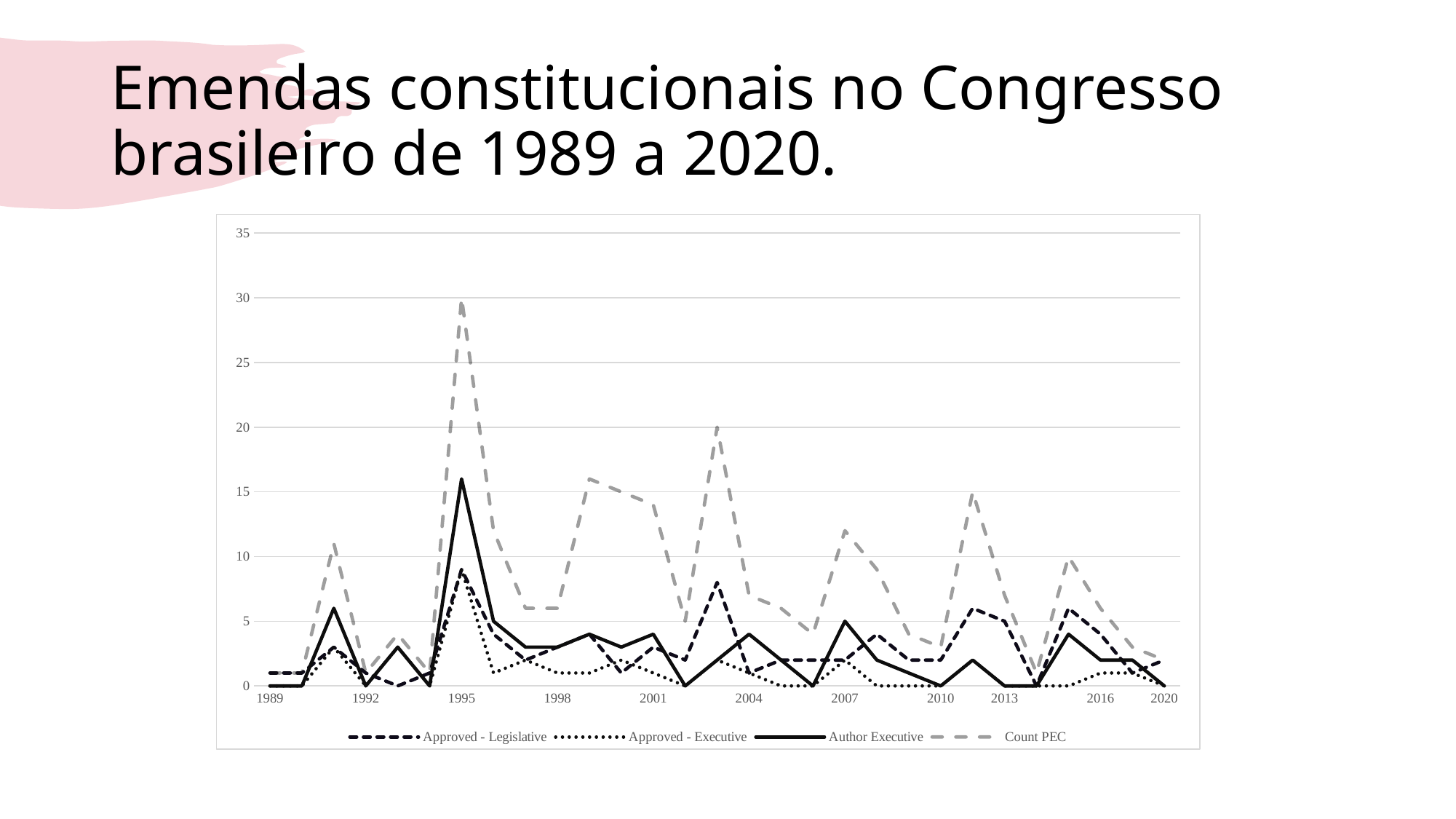
What kind of chart is shown on the slide? line chart Which series is drawn with the light grey dashed line? Count PEC In which year does the Count PEC series reach its highest value? 1995 Which series reaches the highest value anywhere on the chart? Count PEC Is the Author Executive value in 1995 greater or less than 15? greater What is the highest value labelled on the y axis? 35 Is the Count PEC value in 1995 greater or less than 25? greater Does the Count PEC series rise or fall between 1995 and 1998? fall How many year labels are shown on the x axis? 11 How many series does the legend list? 4 Is the Count PEC value in 1989 greater or less than 5? less In 1995, which is larger: Count PEC or Author Executive? Count PEC